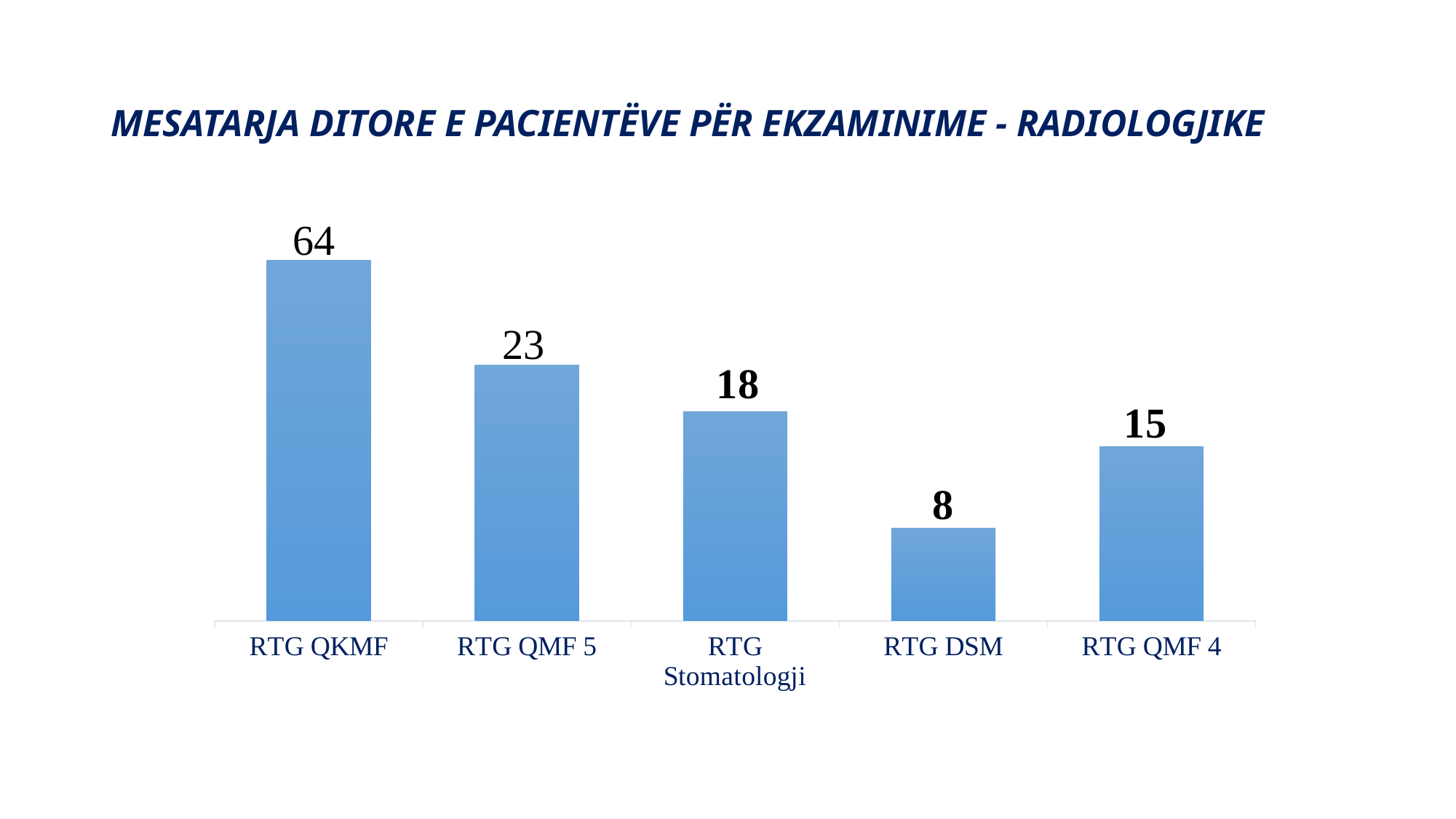
Which category has the highest value? RTG QKMF What is the value for RTG QMF 5? 23 What kind of chart is shown on the slide? Bar chart What is the value for RTG QMF 4? 15 What is the difference between the values for RTG Stomatologji and RTG DSM? 10 What is the value for RTG QKMF? 64 What is the value for RTG Stomatologji? 18 What is the value for RTG DSM? 8 What is the difference between the values for RTG QKMF and RTG QMF 5? 41 Which category has the lowest value? RTG DSM How many categories are shown in the chart? 5 Which is larger, the value for RTG QMF 4 or the value for RTG Stomatologji? RTG Stomatologji